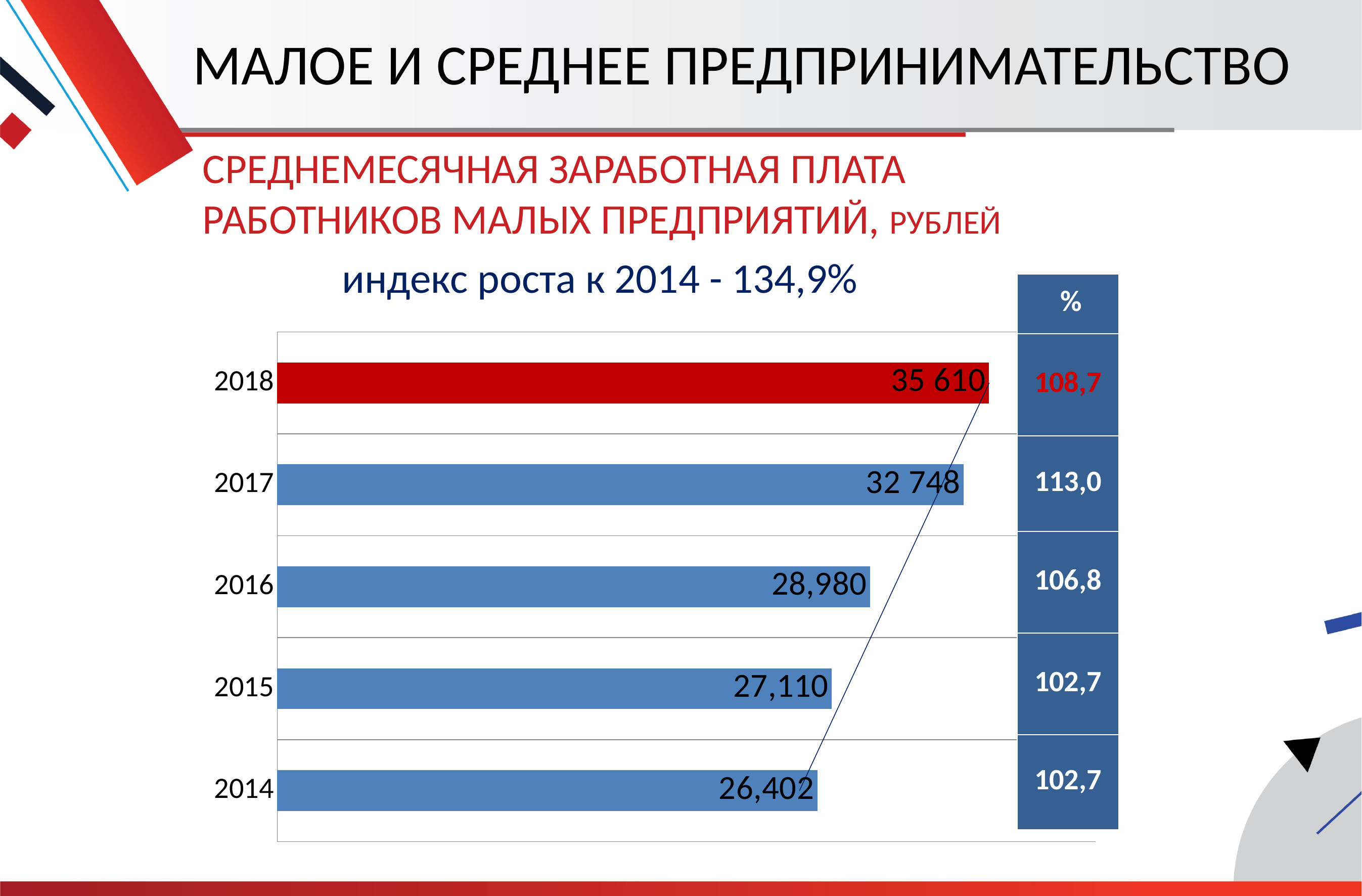
Do the bar values rise or fall from 2014 to 2018? rise What is the difference between the values for 2016 and 2015? 1,870 What colour is the bar for 2018? red What percentage index is shown in the side column for 2017? 113,0 What is the average monthly salary value shown for 2018? 35 610 What is the value shown for 2016? 28,980 What is the value shown for 2014? 26,402 How many years are shown in the bar chart? 5 Which is larger, the value for 2017 or the value for 2016? 2017 Which year has the highest value in the bar chart? 2018 What type of chart is shown on the slide? bar chart Which year has the lowest value in the bar chart? 2014